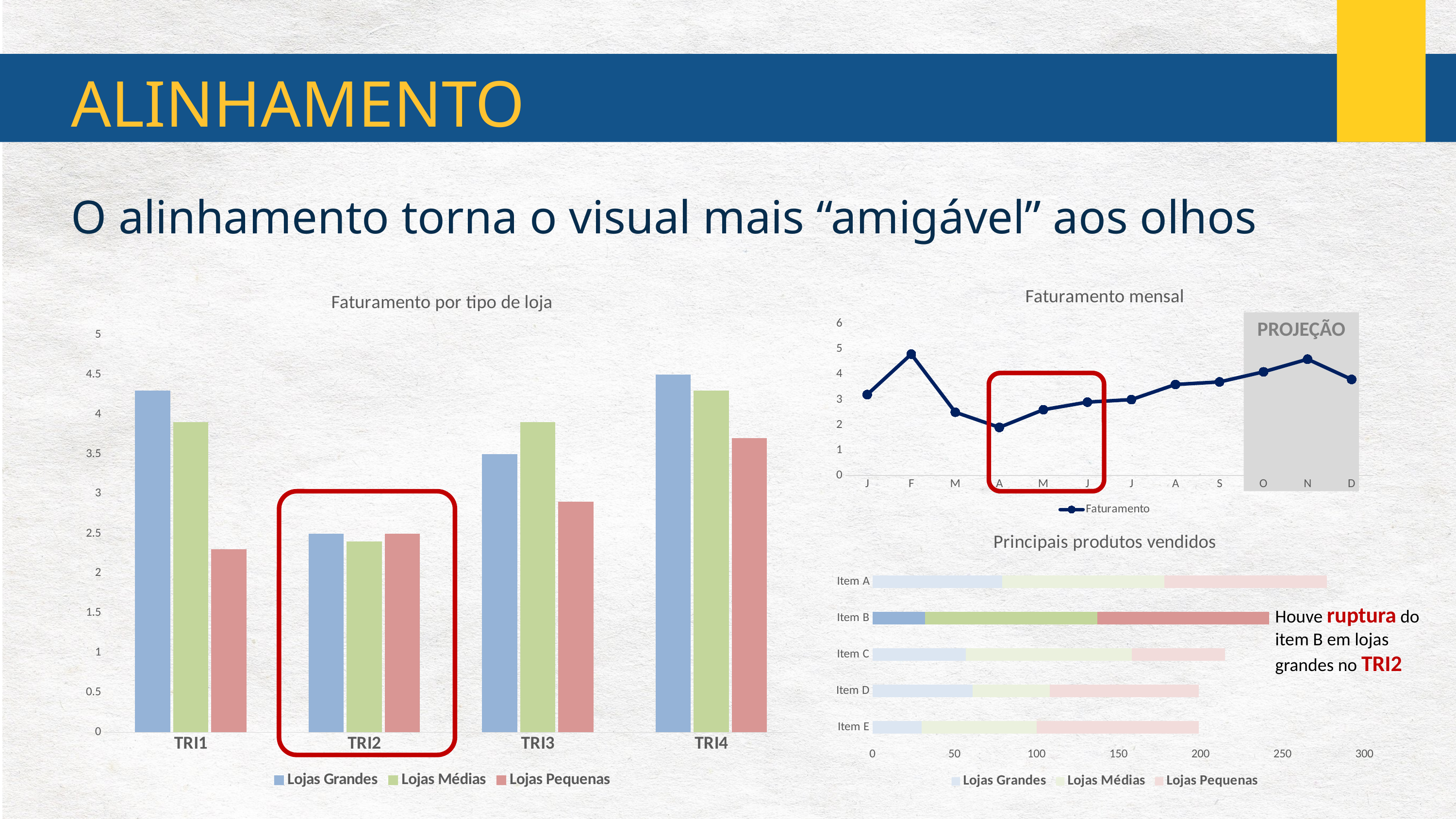
In "Faturamento por tipo de loja", which quarter has the lowest value for Lojas Grandes? TRI2 What kind of chart is "Faturamento por tipo de loja"? bar chart What kind of chart is "Faturamento mensal"? line chart In "Faturamento mensal", which month has the highest value? F In "Faturamento por tipo de loja", which is larger in TRI3: Lojas Grandes or Lojas Médias? Lojas Médias In "Faturamento por tipo de loja", is the value for Lojas Pequenas in TRI1 greater or less than 2.5? less In "Faturamento mensal", which month has the lowest value? A How many series does the legend of "Faturamento por tipo de loja" list? 3 In "Faturamento mensal", what label is shown in the shaded area over the last months? PROJEÇÃO In "Faturamento por tipo de loja", is the value for Lojas Grandes in TRI1 greater or less than 4? greater In "Principais produtos vendidos", which item has the longest total bar? Item A How many categories are shown on the x axis of "Faturamento por tipo de loja"? 4